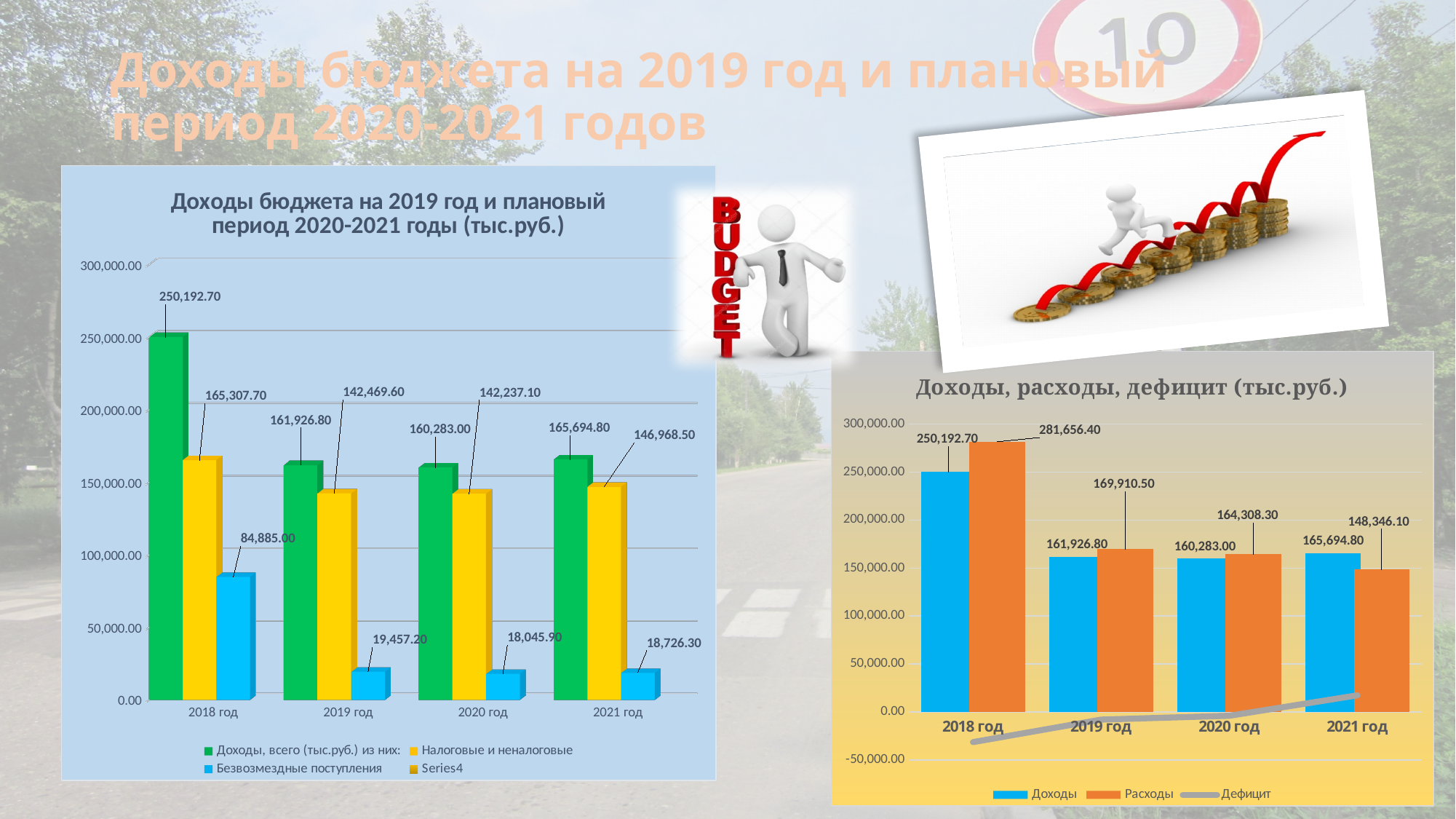
In the right chart 'Доходы, расходы, дефицит (тыс.руб.)', what kind of chart is used for 'Доходы' and 'Расходы'? Bar chart In the left chart 'Доходы бюджета на 2019 год и плановый период 2020-2021 годы', which year has the highest value of 'Налоговые и неналоговые'? 2018 год In the left chart 'Доходы бюджета на 2019 год и плановый период 2020-2021 годы', how many years are shown on the x axis? 4 In the left chart 'Доходы бюджета на 2019 год и плановый период 2020-2021 годы', how many series does the legend list? 4 In the right chart 'Доходы, расходы, дефицит (тыс.руб.)', what is the difference between 'Расходы' and 'Доходы' for 2018 год? 31,463.70 In the right chart 'Доходы, расходы, дефицит (тыс.руб.)', which is larger for 2021 год: 'Доходы' or 'Расходы'? Доходы In the left chart 'Доходы бюджета на 2019 год и плановый период 2020-2021 годы', what is the value of 'Безвозмездные поступления' for 2020 год? 18,045.90 In the left chart 'Доходы бюджета на 2019 год и плановый период 2020-2021 годы', what is the value of 'Доходы, всего' for 2018 год? 250,192.70 In the right chart 'Доходы, расходы, дефицит (тыс.руб.)', which year has the lowest value of 'Расходы'? 2021 год In the right chart 'Доходы, расходы, дефицит (тыс.руб.)', what is the value of 'Расходы' for 2019 год? 169,910.50 In the right chart 'Доходы, расходы, дефицит (тыс.руб.)', which series is drawn as a line? Дефицит In the left chart 'Доходы бюджета на 2019 год и плановый период 2020-2021 годы', what is the difference between 'Доходы, всего' and 'Налоговые и неналоговые' for 2021 год? 18,726.30